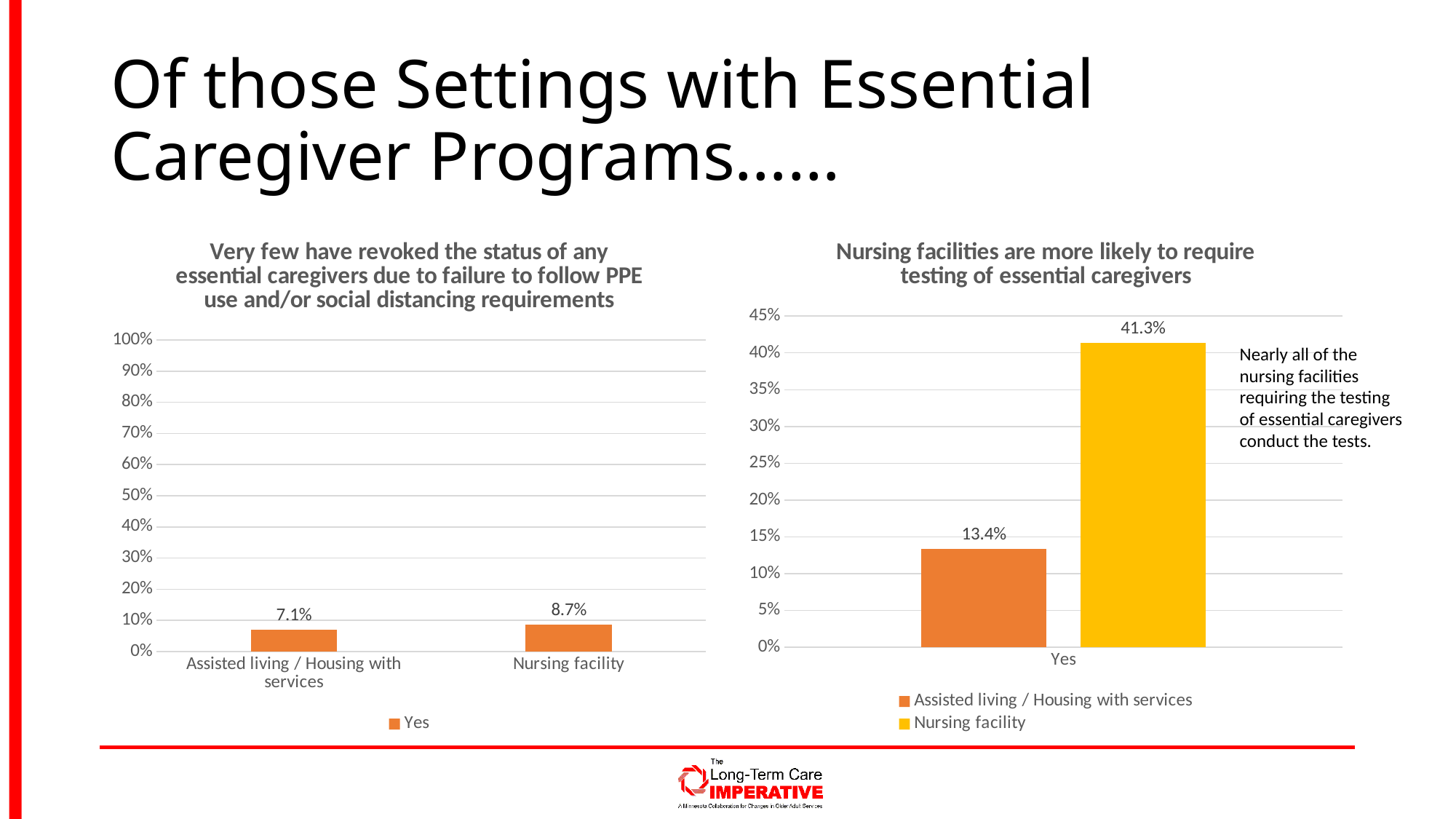
In the right chart, what is the difference between the Nursing facility value and the Assisted living / Housing with services value? 27.9% In the right chart, what is the value for Nursing facility? 41.3% In the left chart, what is the value for Assisted living / Housing with services? 7.1% What type of chart is the right chart? Bar chart In the left chart, which category has the higher value? Nursing facility In the left chart, is the value for Nursing facility greater or less than 10%? less In the left chart, what is the difference between the Nursing facility value and the Assisted living / Housing with services value? 1.6% In the right chart, what is the value for Assisted living / Housing with services? 13.4% In the right chart, how many series does the legend list? 2 In the left chart, what is the value for Nursing facility? 8.7% In the right chart, which series has the lower value? Assisted living / Housing with services In the left chart, how many categories are shown on the x axis? 2